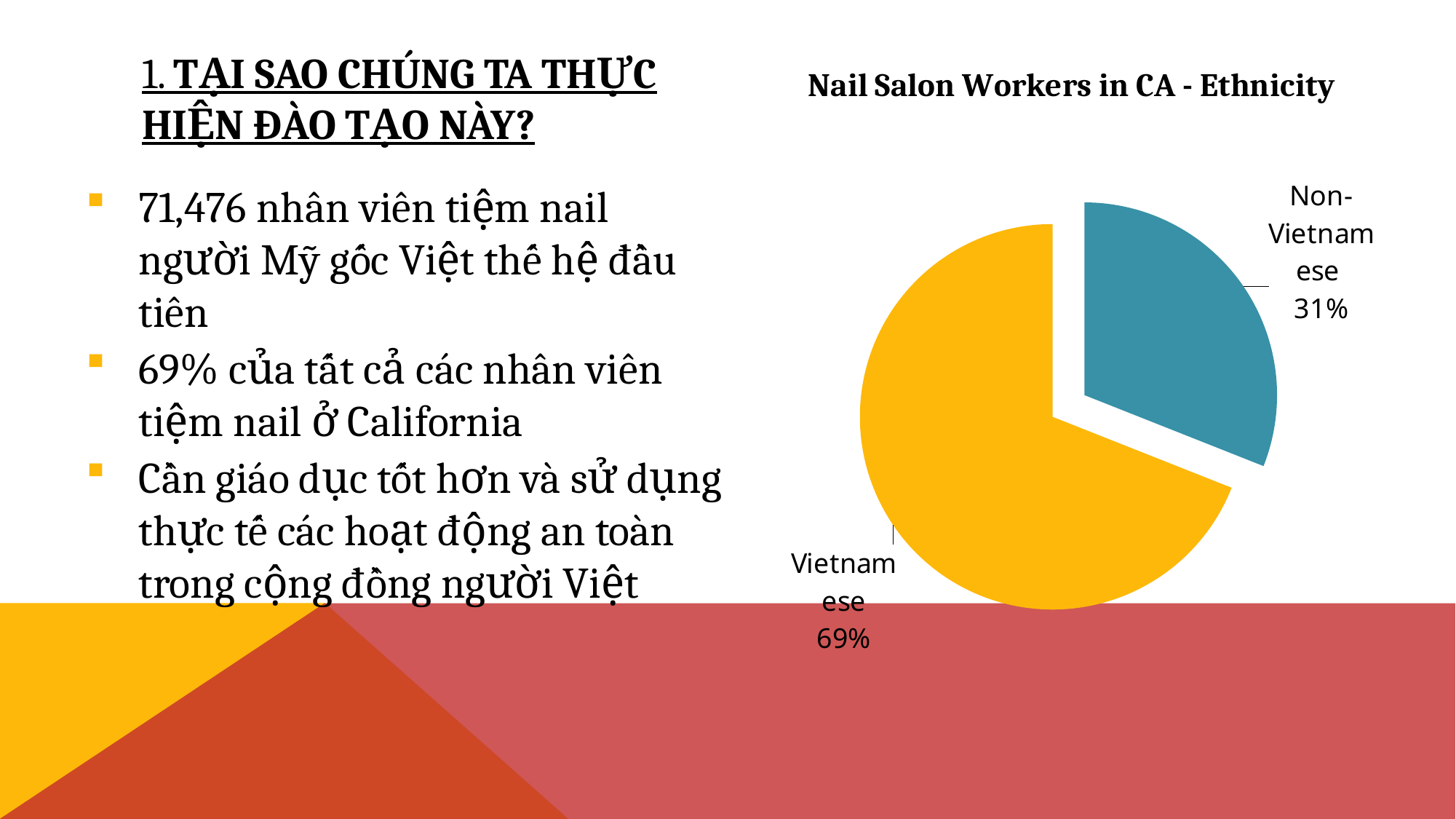
What share of the pie is labelled Vietnamese? 69% How many slices does the pie chart have? 2 Is the Vietnamese share greater or less than 50%? greater What is the title of the chart? Nail Salon Workers in CA - Ethnicity Which slice of the pie is the smallest? Non-Vietnamese What share of the pie is labelled Non-Vietnamese? 31% What kind of chart is shown on the slide? pie chart What is the difference in percentage points between the Vietnamese and Non-Vietnamese slices? 38 What colour is the Non-Vietnamese slice? teal Which is larger, the Vietnamese slice or the Non-Vietnamese slice? Vietnamese Which slice of the pie is the largest? Vietnamese